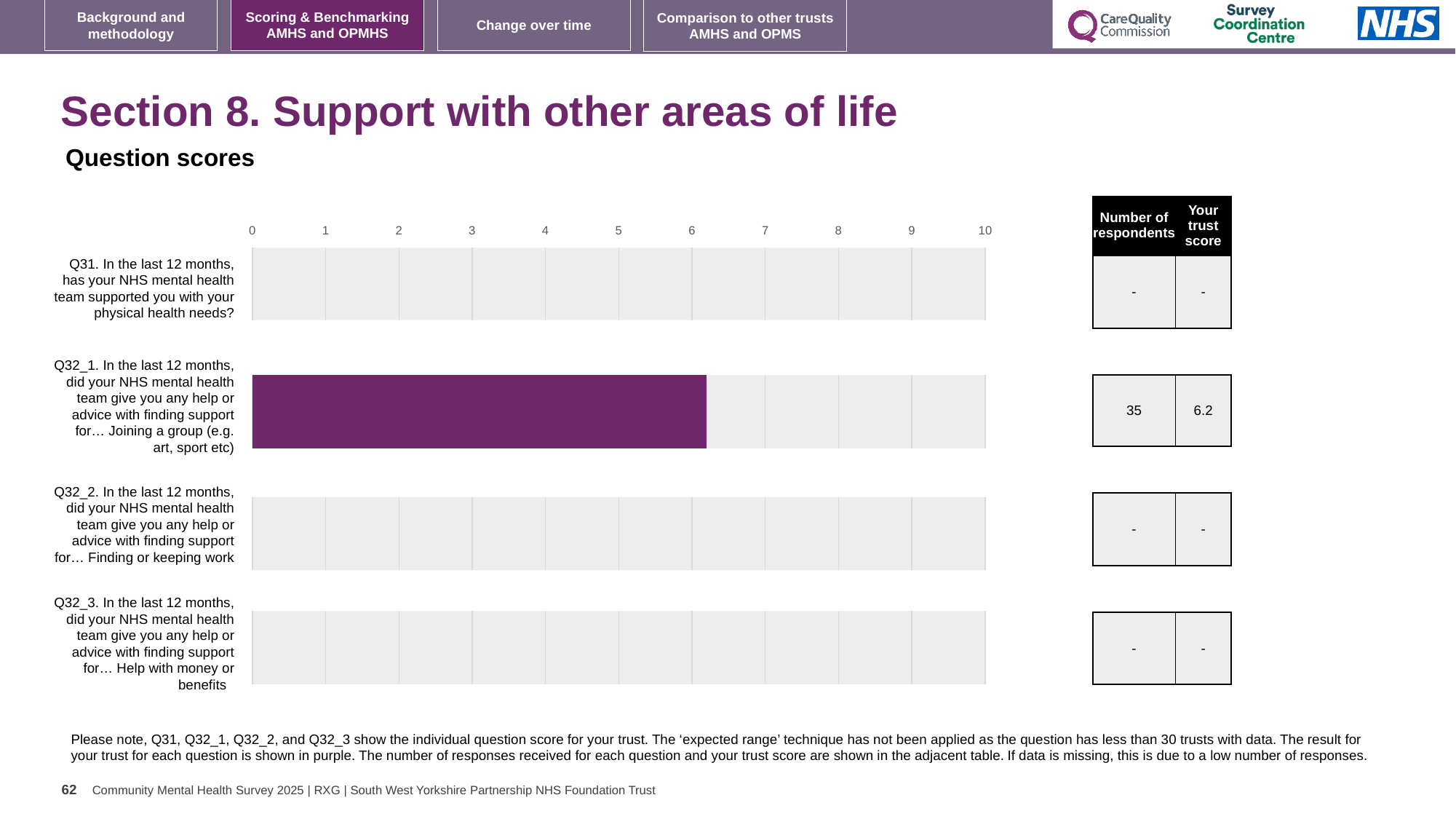
What is the trust score shown for Q32_3 (help with money or benefits)? - What colour is the bar representing the trust's result? purple What is shown in the table for the number of respondents for Q31? - What is the maximum value shown on the chart's x axis? 10 Is the value for Q32_1 greater or less than 7? less Which question is the only one with a plotted bar on the chart? Q32_1 Is the value for Q32_1 greater or less than 5? greater How many questions on the chart have no data shown (marked with '-')? 3 How many questions (categories) are listed on the chart? 4 How many respondents answered Q32_1 (joining a group)? 35 What is the trust score for Q32_1 (help or advice with finding support for joining a group)? 6.2 What kind of chart is shown on the slide? bar chart